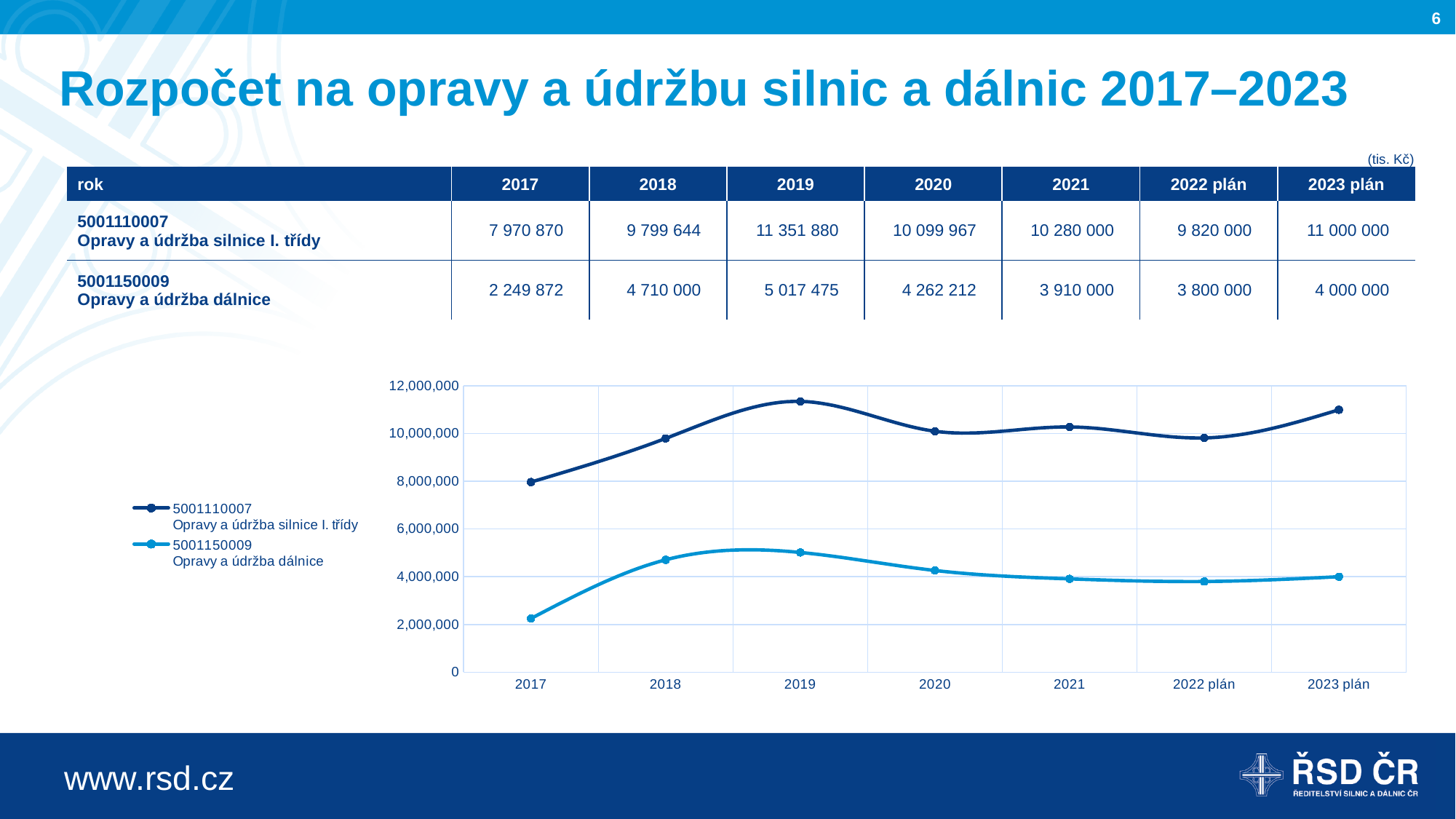
How many series does the chart legend list? 2 In which year is the value for 5001110007 Opravy a údržba silnice I. třídy highest? 2019 What is the value for 5001110007 Opravy a údržba silnice I. třídy in 2019? 11 351 880 What is the difference between the 2023 plán values for Opravy a údržba silnice I. třídy and Opravy a údržba dálnice? 7 000 000 What type of chart is shown on the slide? line chart In which year is the value for 5001150009 Opravy a údržba dálnice lowest? 2017 What unit is stated above the table for the values on the slide? tis. Kč How many points along the x axis does each line in the chart have? 7 Which series has the larger value in 2021, Opravy a údržba silnice I. třídy or Opravy a údržba dálnice? Opravy a údržba silnice I. třídy What is the value for 5001150009 Opravy a údržba dálnice in 2017? 2 249 872 Does the line for 5001110007 Opravy a údržba silnice I. třídy rise or fall from 2017 to 2019? rise Is the value for 5001150009 Opravy a údržba dálnice in 2019 greater or less than 4,000,000? greater